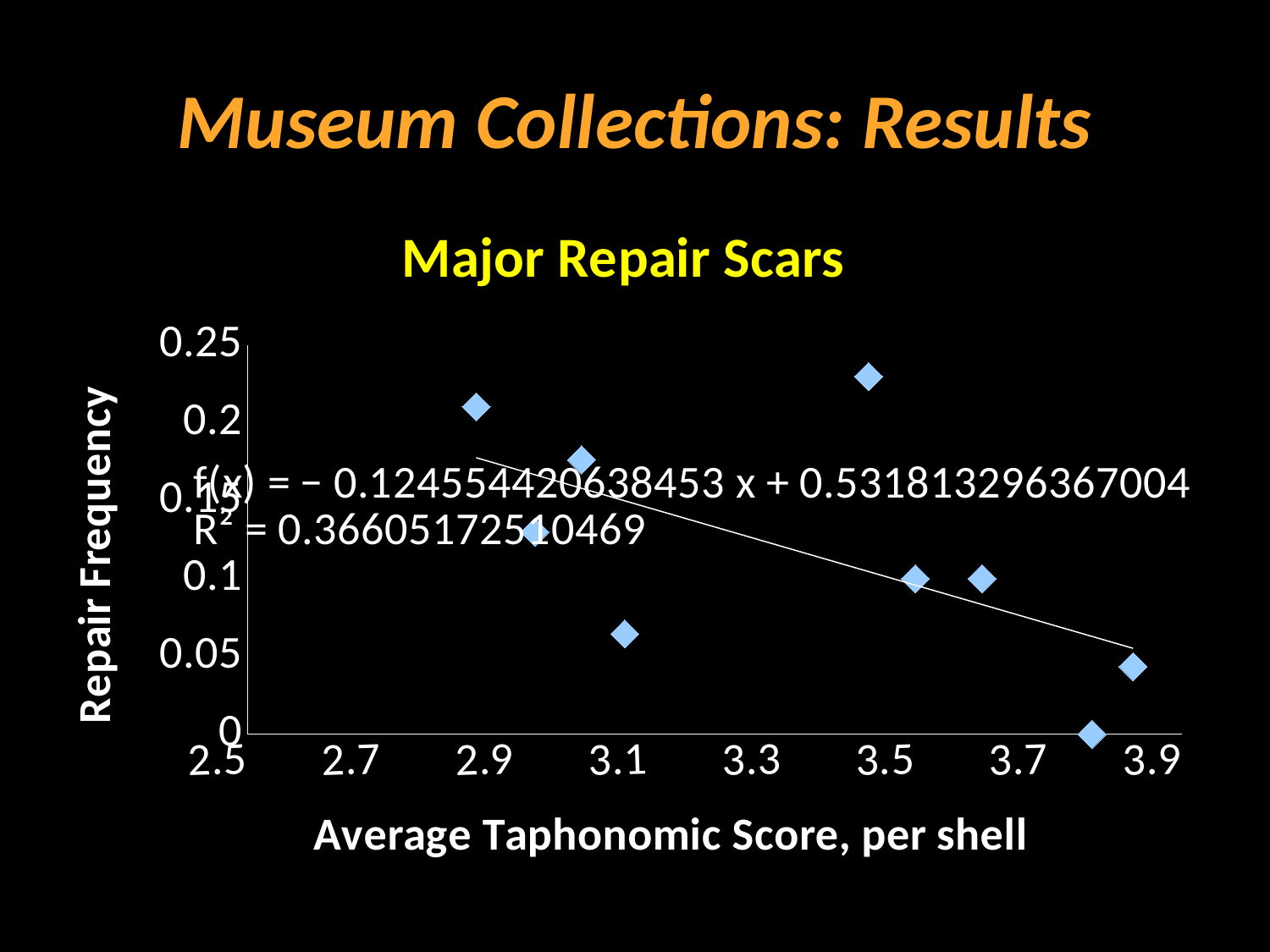
What is the title of the chart? Major Repair Scars Is the repair frequency of the point near an average taphonomic score of 3.1 greater or less than 0.1? less What is the label of the x axis? Average Taphonomic Score, per shell What kind of chart is shown on the slide? scatter chart Is the repair frequency of the point near an average taphonomic score of 3.9 greater or less than 0.05? less What is the slope of the trendline equation printed on the chart? −0.124554420638453 According to the trendline, do repair frequency values rise or fall as the average taphonomic score increases? fall How many data points are plotted on the chart? 9 What R² value is printed on the chart? 0.36605172510469 Which has the higher repair frequency: the point near an average taphonomic score of 2.9 or the point near 3.7? the point near 2.9 What is the intercept of the trendline equation printed on the chart? 0.531813296367004